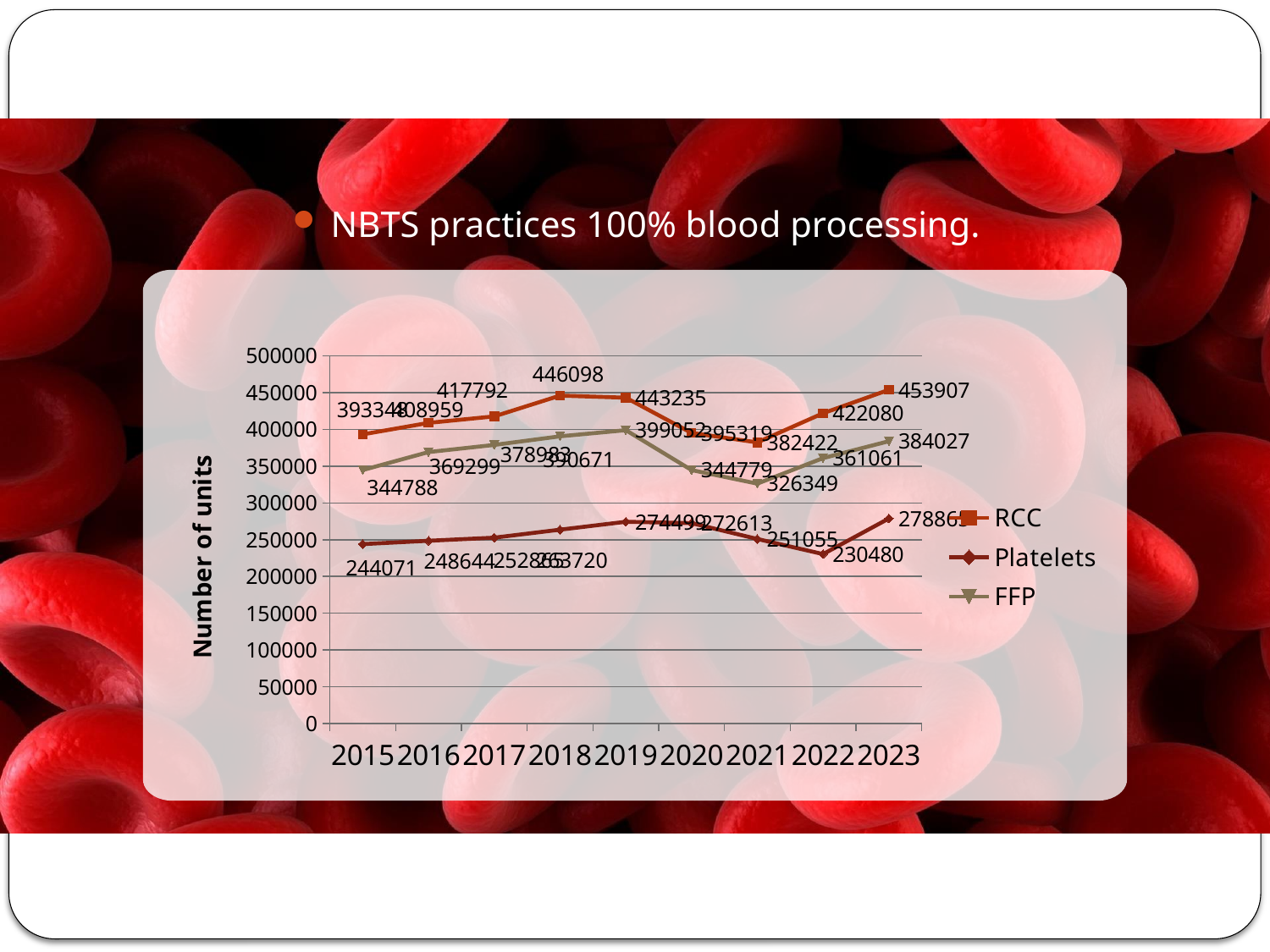
What is the RCC value for 2023? 453907 What is the FFP value for 2015? 344788 What is the Platelets value for 2022? 230480 In which year is the Platelets value lowest? 2022 In which year is the RCC value highest? 2023 In which year is the FFP value lowest? 2021 What type of chart is shown on the slide? line chart How many series does the legend list? 3 Which year has the larger FFP value, 2018 or 2020? 2018 What is the RCC value for 2018? 446098 How many years are plotted along the x axis? 9 What is the difference between the RCC values for 2023 and 2022? 31827